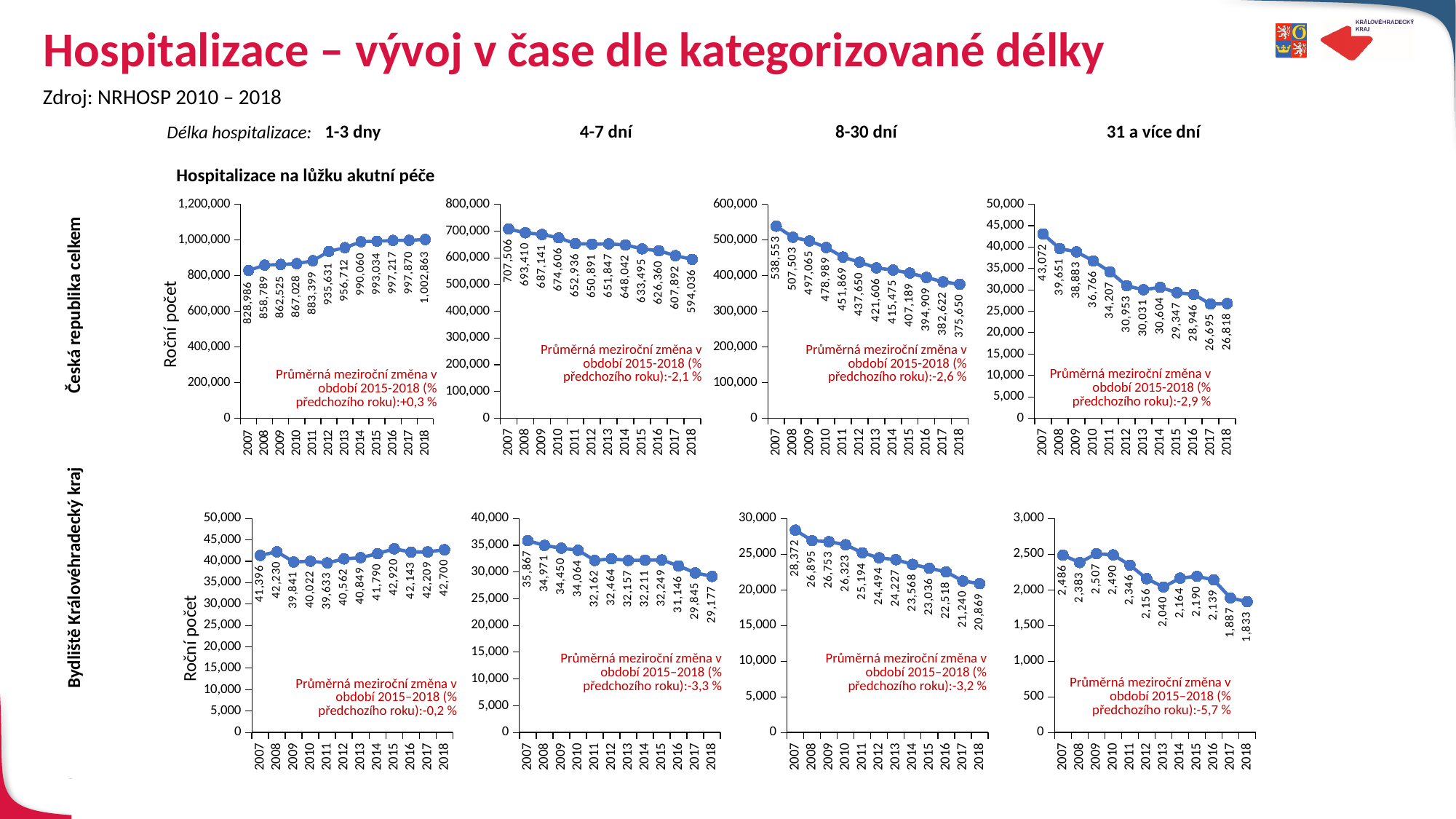
In the top-row chart for 1-3 dny (Česká republika celkem), what is the value for 2018? 1,002,863 In the top-row chart for 8-30 dní (Česká republika celkem), do the values rise or fall from 2007 to 2018? fall What average year-on-year change for 2015–2018 is stated in the bottom-row chart for 31 a více dní (Bydliště Královéhradecký kraj)? -5,7 % In the bottom-row chart for 4-7 dní (Bydliště Královéhradecký kraj), which year has the lowest value? 2018 In the bottom-row chart for 8-30 dní (Bydliště Královéhradecký kraj), what is the value for 2012? 24,494 In the bottom-row chart for 31 a více dní (Bydliště Královéhradecký kraj), what is the value for 2007? 2,486 In the top-row chart for 4-7 dní (Česká republika celkem), is the value for 2018 greater or less than 600,000? less What kind of chart is used for the top-row 8-30 dní chart? line chart In the top-row chart for 31 a více dní (Česká republika celkem), what is the difference between the 2007 value and the 2018 value? 16,254 In the top-row chart for 8-30 dní (Česká republika celkem), which year has the highest value? 2007 How many years are plotted on the x axis of the top-row chart for 1-3 dny? 12 In the bottom-row chart for 1-3 dny (Bydliště Královéhradecký kraj), which year has the larger value, 2008 or 2015? 2015